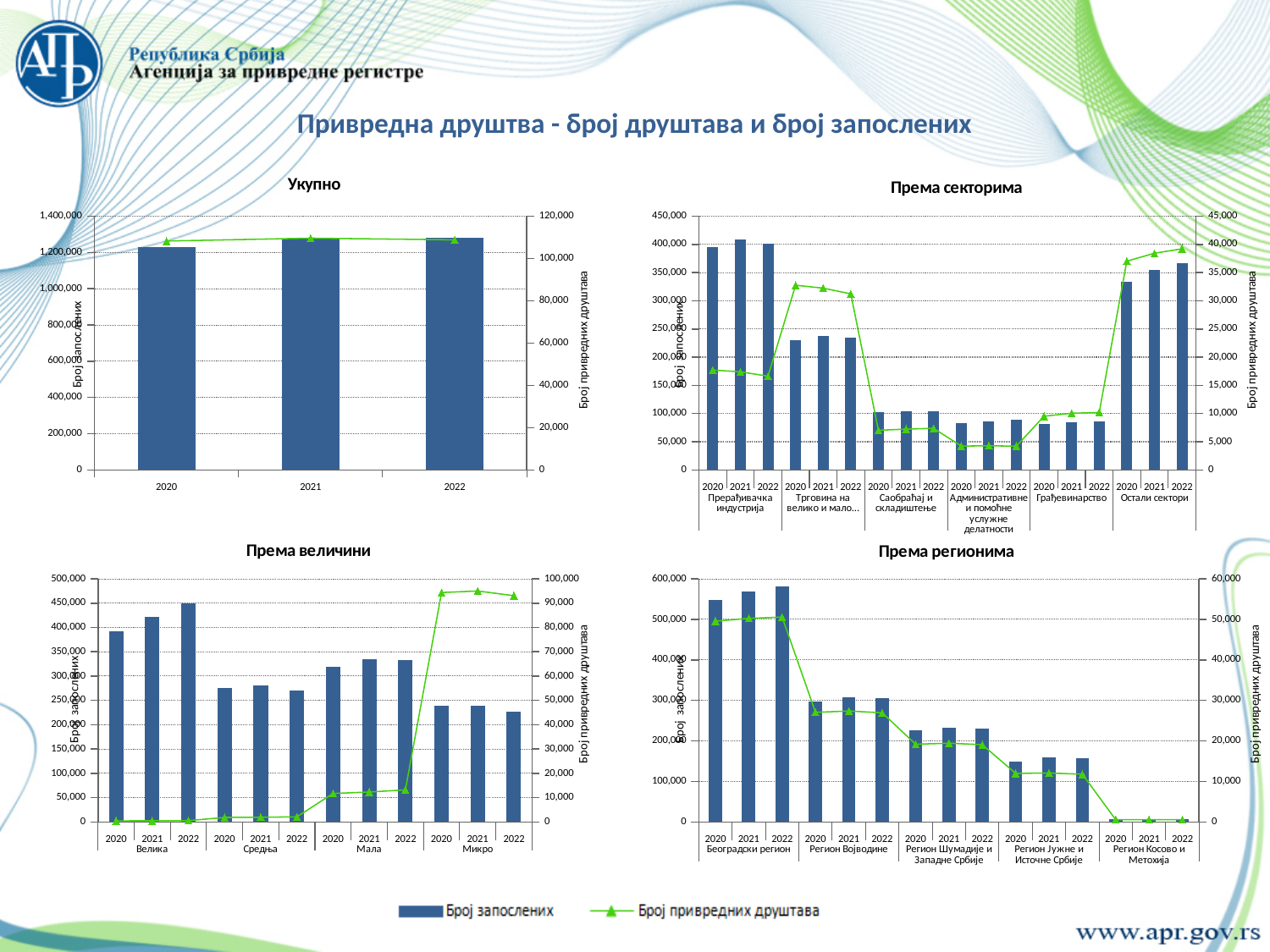
How many charts are shown on the slide? 4 In the 'Према величини' chart, does the number of employees for Велика rise or fall from 2020 to 2022? rise In the 'Према величини' chart, which size category has the highest number of companies (Број привредних друштава)? Микро In the 'Према величини' chart, is the number of employees for Велика in 2022 greater or less than 400,000? greater In the 'Према секторима' chart, is the number of employees in Прерађивачка индустрија in 2020 greater or less than 350,000? greater In the 'Према секторима' chart, which sector has the tallest bar for number of employees? Прерађивачка индустрија In the 'Према секторима' chart, which sector has the highest number of companies (Број привредних друштава) in 2022? Остали сектори In the 'Укупно' chart, is the number of employees (Број запослених) for 2020 greater or less than 1,000,000? greater In the 'Укупно' chart, how many years are shown on the x axis? 3 In the 'Према регионима' chart, which region has the lowest number of employees? Регион Косово и Метохија How many series does the shared legend at the bottom of the slide list? 2